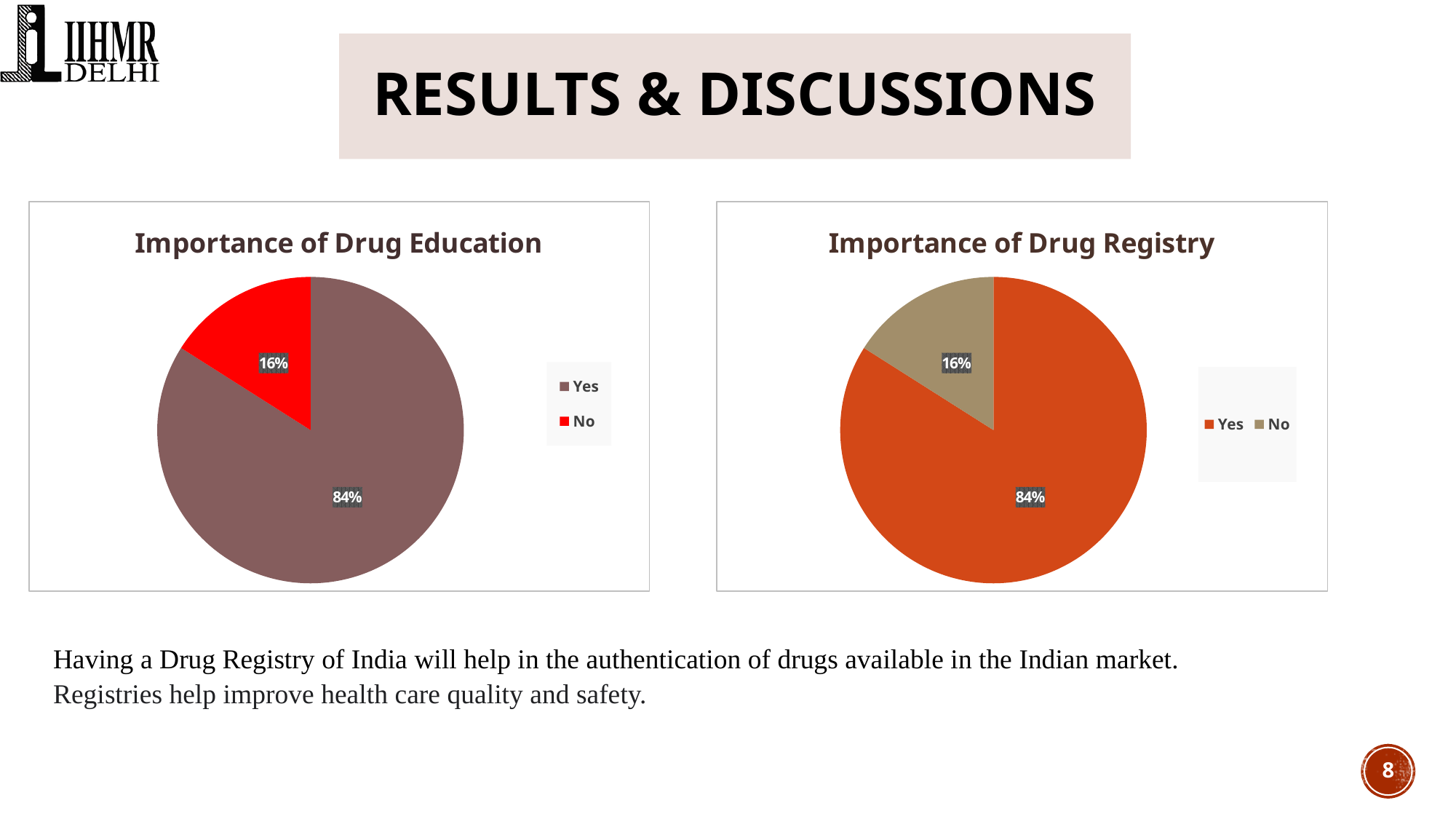
In the 'Importance of Drug Education' chart, what colour is the 'No' slice? Red What kind of chart is the 'Importance of Drug Education' chart? Pie chart In the 'Importance of Drug Education' chart, what is the difference between the 'Yes' and 'No' shares? 68% In the 'Importance of Drug Registry' chart, what share of the pie is 'No'? 16% What is the title of the chart on the right of the slide? Importance of Drug Registry In the 'Importance of Drug Education' chart, what share of the pie is 'No'? 16% In the 'Importance of Drug Registry' chart, which category has the smallest slice? No In the 'Importance of Drug Registry' chart, which is larger, 'Yes' or 'No'? Yes How many categories does the 'Importance of Drug Registry' chart show? 2 In the 'Importance of Drug Education' chart, which category has the largest slice? Yes In the 'Importance of Drug Education' chart, what share of the pie is 'Yes'? 84%